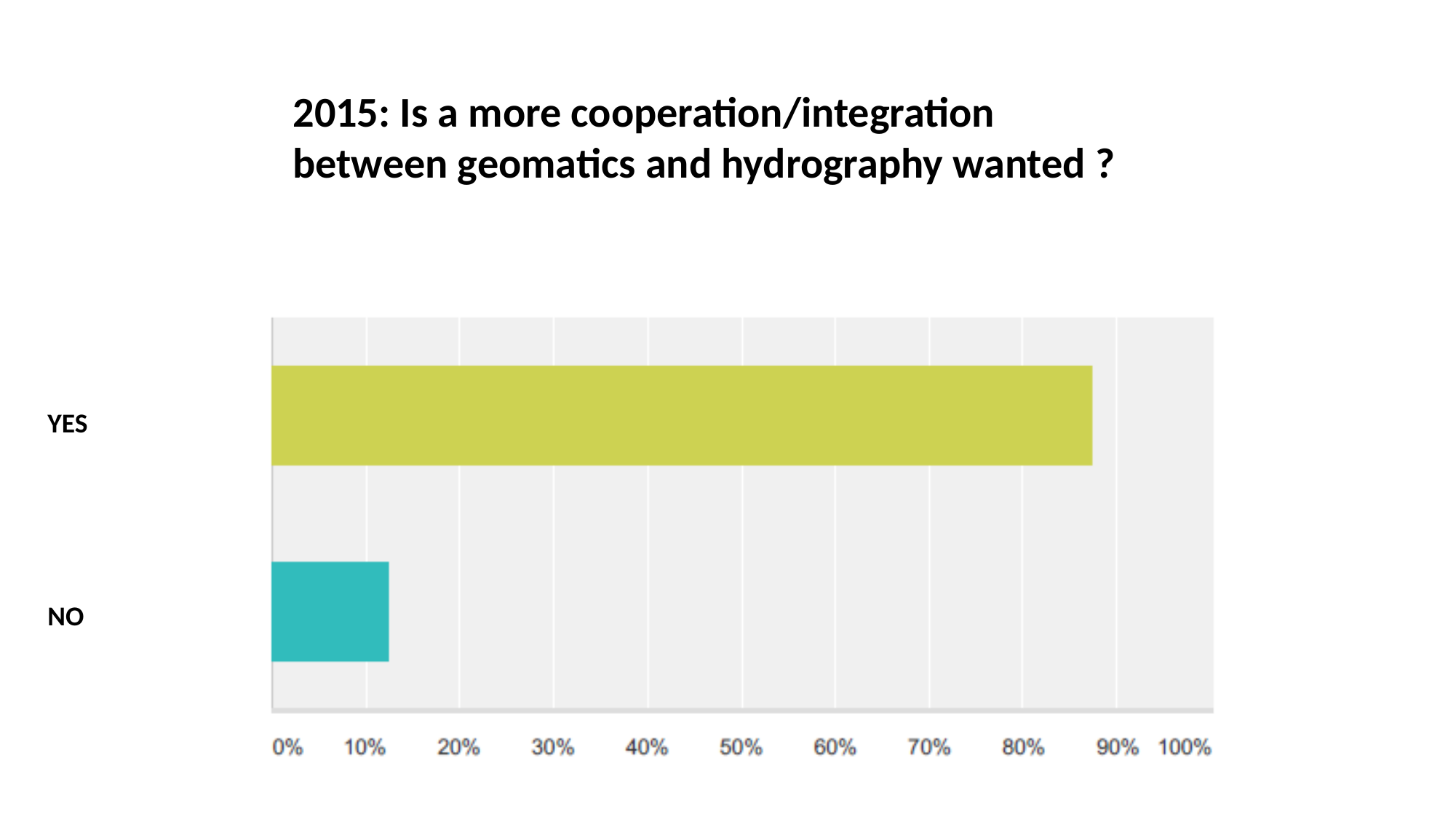
Which category has the highest value? YES How many categories does the chart show? 2 Is the value for NO greater or less than 20%? less What is the highest value shown on the x axis? 100% What kind of chart is shown on the slide? bar chart Is the value for YES greater or less than 90%? less Which category has the lowest value? NO What colour is the bar for NO? teal What is the title of the chart? 2015: Is a more cooperation/integration between geomatics and hydrography wanted ? Which is larger, the value for YES or the value for NO? YES Is the value for NO greater or less than 10%? greater